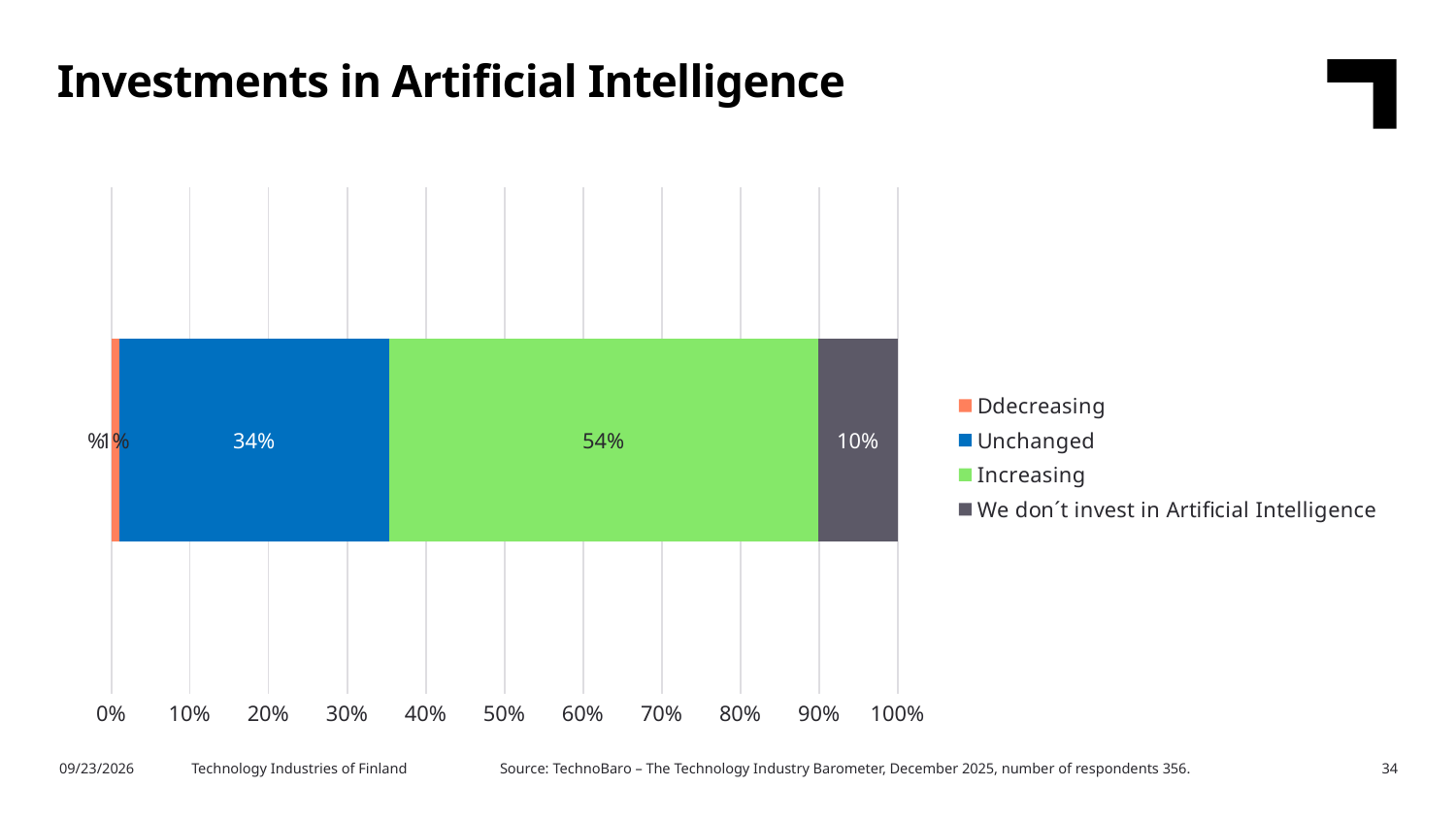
What is the difference in percentage points between the Increasing and Unchanged shares? 20% What colour represents the Increasing segment in the chart? Green Which is larger, the Unchanged share or the Increasing share? Increasing Which response category has the largest share in the chart? Increasing What percentage of respondents say they don't invest in Artificial Intelligence? 10% What is the title of the chart on the slide? Investments in Artificial Intelligence What percentage of respondents report their investments in Artificial Intelligence are unchanged? 34% What percentage of respondents report their investments in Artificial Intelligence are increasing? 54% What is the difference in percentage points between the Unchanged share and the share that doesn't invest in Artificial Intelligence? 24% Which response category has the smallest share in the chart? Ddecreasing What kind of chart is shown on the slide? Stacked bar chart How many series does the legend list? 4